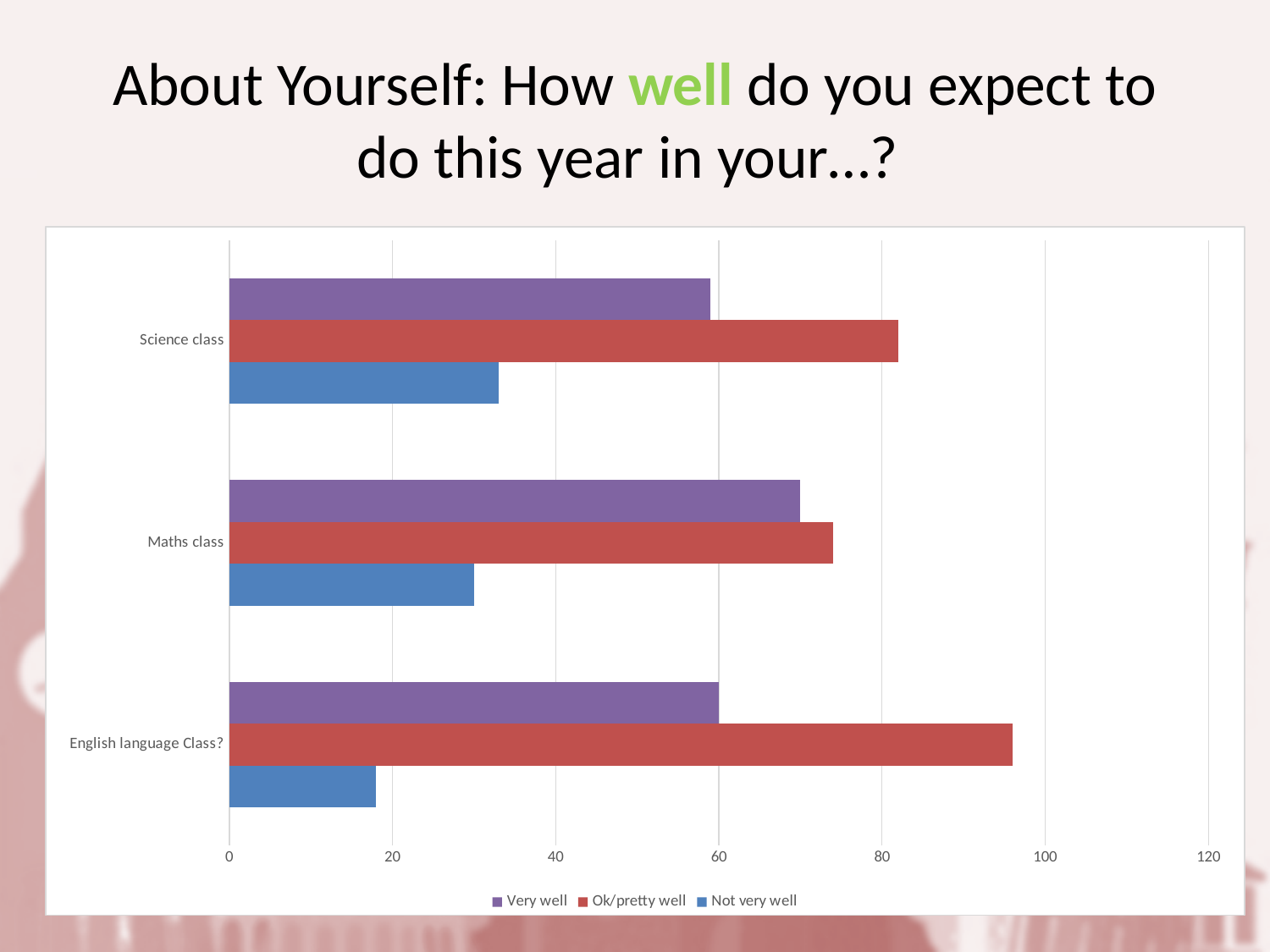
How many classes (categories) are shown on the chart? 3 Is the 'Ok/pretty well' value for English language Class? greater or less than 80? greater How many series does the legend list? 3 Is the 'Ok/pretty well' value for Science class greater or less than 100? less Which class has the lowest 'Not very well' value? English language Class? Is the 'Not very well' value for English language Class? greater or less than 20? less Which series is represented by the red bars? Ok/pretty well For Science class, which is larger: the 'Very well' value or the 'Not very well' value? Very well Which class has the highest 'Ok/pretty well' value? English language Class? What kind of chart is shown on the slide? bar chart